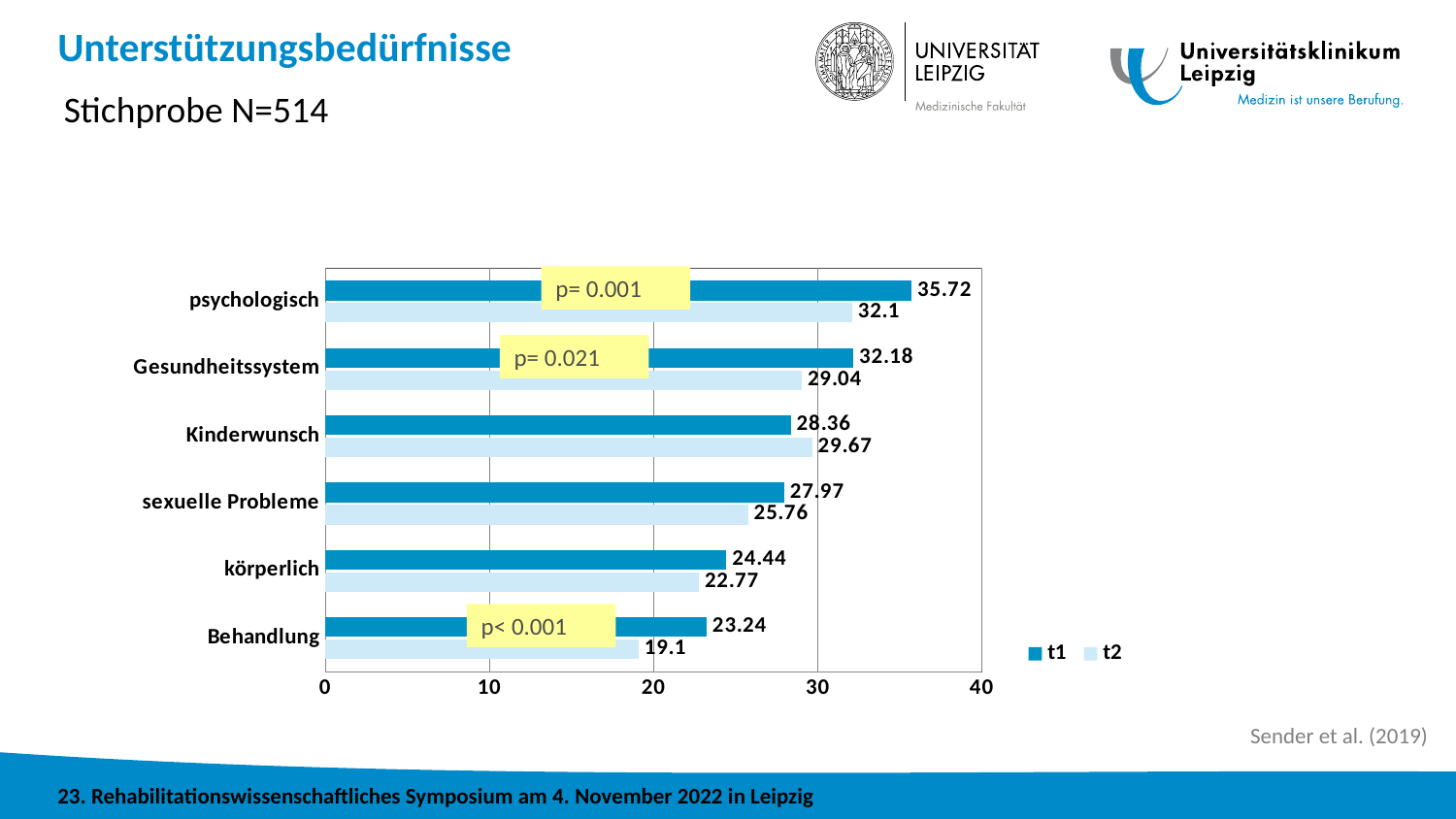
What is the t2 value for Kinderwunsch? 29.67 What is the difference between the t1 values for psychologisch and Gesundheitssystem? 3.54 What is the difference between the t1 and t2 values for Behandlung? 4.14 What kind of chart is shown on the slide? bar chart For Kinderwunsch, which is larger, the t1 value or the t2 value? t2 Which category has the lowest t2 value? Behandlung What is the t1 value for psychologisch? 35.72 What is the t2 value for Behandlung? 19.1 Is the t1 value for körperlich greater or less than 20? greater How many categories are shown on the chart? 6 How many series does the legend list? 2 Which category has the highest t1 value? psychologisch